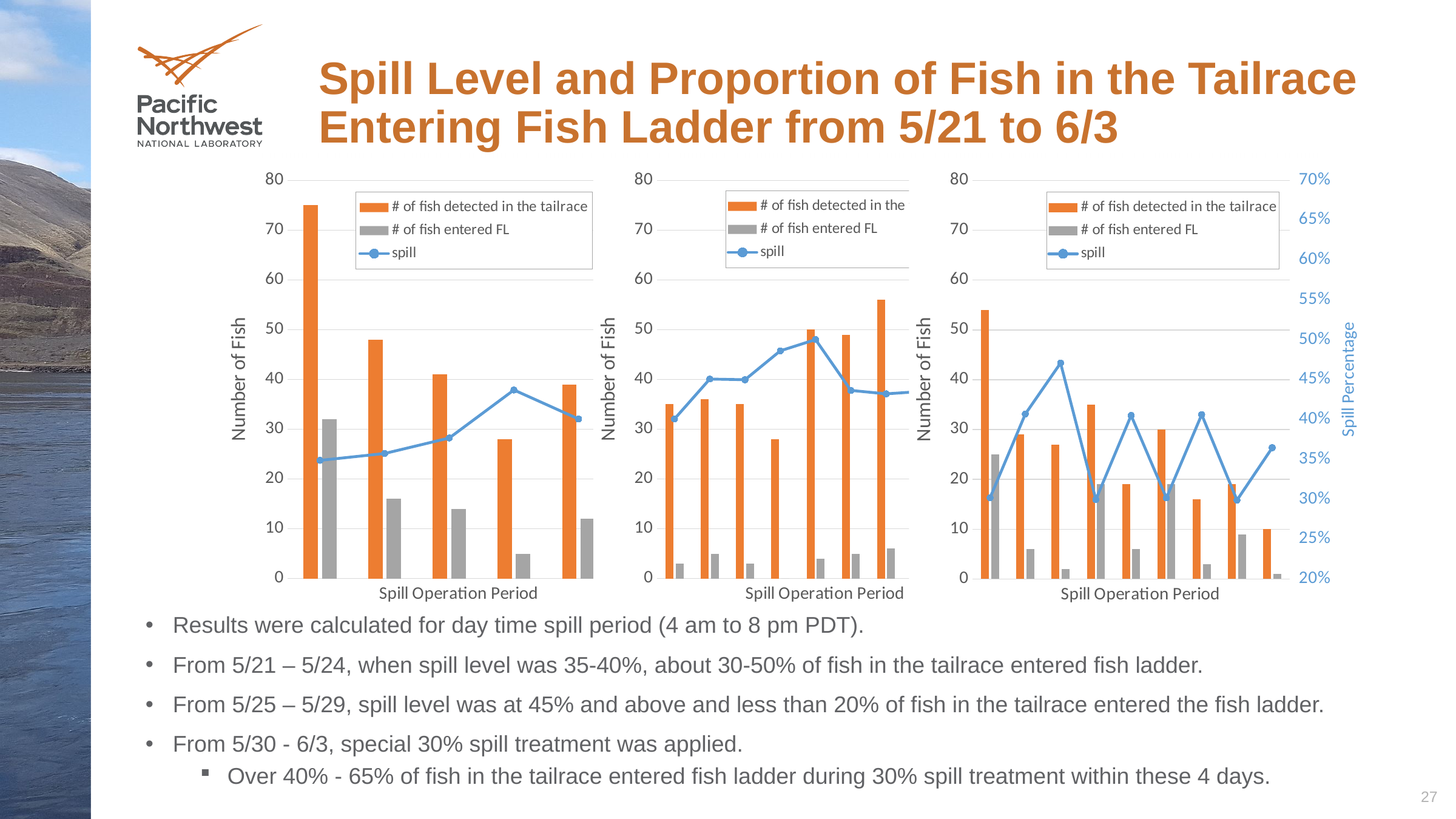
In the left chart, is the first orange bar (# of fish detected in the tailrace) greater or less than 70? greater In the middle chart, is the last orange bar (# of fish detected in the tailrace) greater or less than 50? greater What is the x-axis title shown under each of the three charts? Spill Operation Period What is the label of the secondary (right-hand) vertical axis on the right chart? Spill Percentage How many series does the legend of the left chart list? 3 In the left chart, which is larger: the first orange bar or the second orange bar? the first orange bar In the left chart, which spill operation period has the highest number of fish detected in the tailrace? the first period What type of chart is the left chart on the slide? bar chart with a line In the right chart, is the last orange bar (# of fish detected in the tailrace) greater or less than 20? less How many orange bars (# of fish detected in the tailrace) are plotted in the left chart? 5 How many orange bars (# of fish detected in the tailrace) are plotted in the middle chart? 7